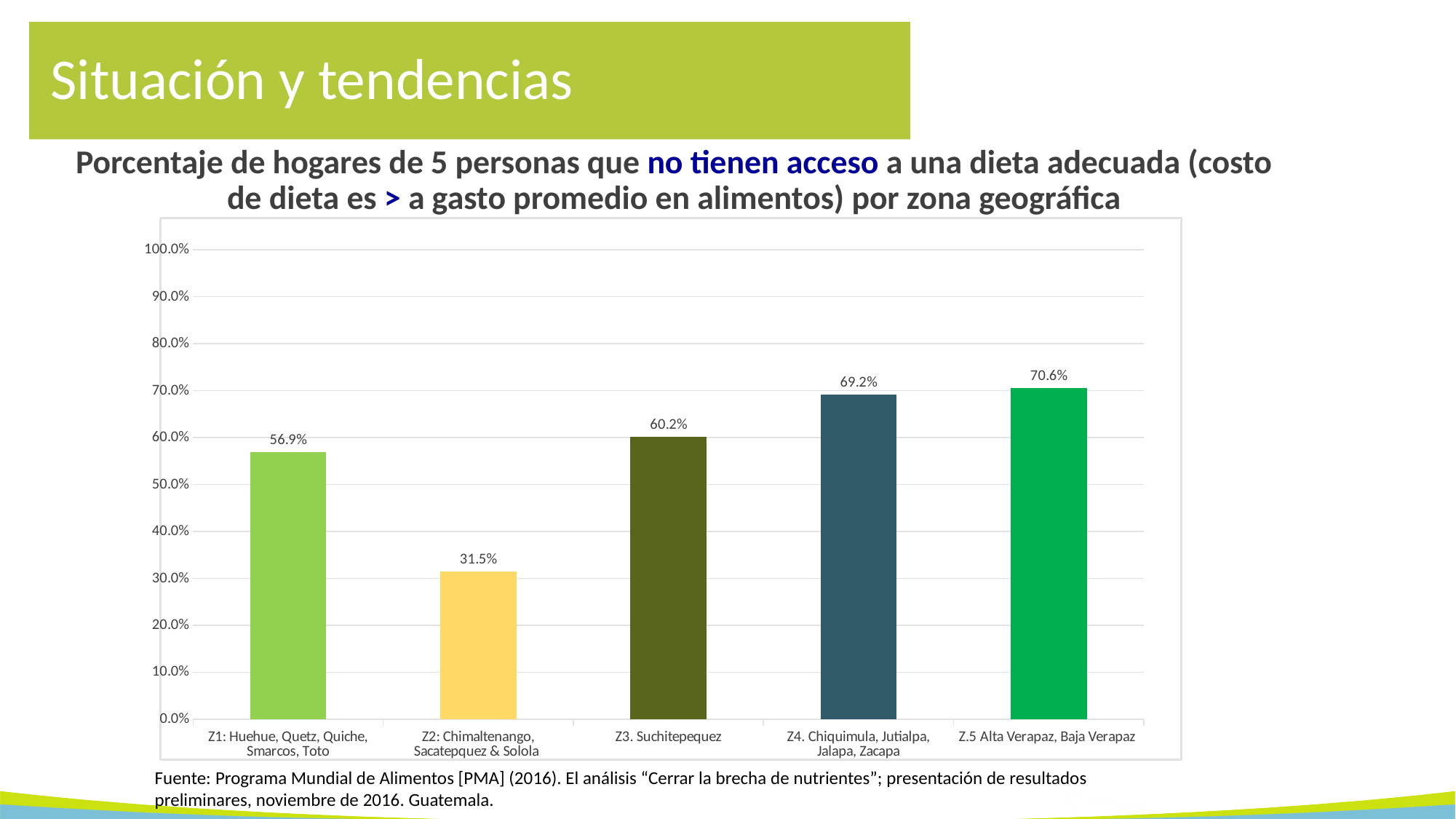
Which zone has the highest percentage? Z.5 Alta Verapaz, Baja Verapaz How many zones are shown in the chart? 5 Which zone has the lowest percentage? Z2: Chimaltenango, Sacatepquez & Solola What is the difference between the values for Z4. Chiquimula, Jutialpa, Jalapa, Zacapa and Z1: Huehue, Quetz, Quiche, Smarcos, Toto? 12.3% What is the value for Z.5 Alta Verapaz, Baja Verapaz? 70.6% Which is larger, the value for Z1: Huehue, Quetz, Quiche, Smarcos, Toto or the value for Z3. Suchitepequez? Z3. Suchitepequez Is the value for Z4. Chiquimula, Jutialpa, Jalapa, Zacapa greater or less than 60.0%? greater What is the highest value shown on the y axis? 100.0% What is the value for Z3. Suchitepequez? 60.2% What is the value for Z2: Chimaltenango, Sacatepquez & Solola? 31.5% What kind of chart is shown on the slide? bar chart What is the difference between the values for Z3. Suchitepequez and Z2: Chimaltenango, Sacatepquez & Solola? 28.7%